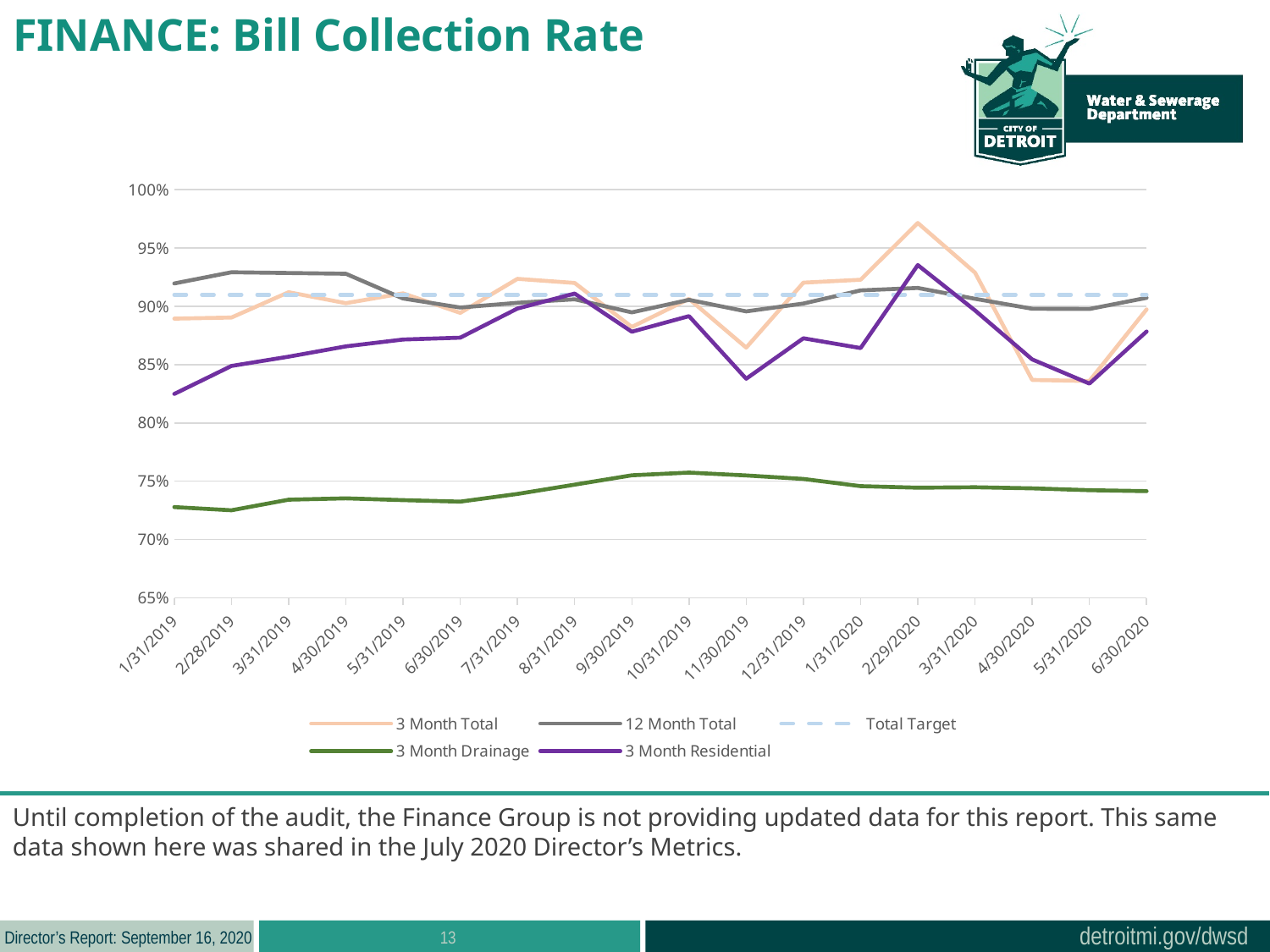
How many series does the legend list? 5 Is the value for 3 Month Total at 2/29/2020 greater or less than 95%? greater How many dates are shown along the x axis? 18 Is the value for 12 Month Total at 2/28/2019 greater or less than 90%? greater Does the 3 Month Residential series rise or fall from 1/31/2019 to 8/31/2019? Rise Is the value for 3 Month Drainage at 1/31/2019 greater or less than 75%? less Which series is drawn as a dashed line? Total Target At which date does the 3 Month Total series reach its highest value? 2/29/2020 At which date does the 3 Month Residential series reach its highest value? 2/29/2020 What kind of chart is shown on the slide? Line chart At 1/31/2019, which is higher: 3 Month Total or 3 Month Residential? 3 Month Total